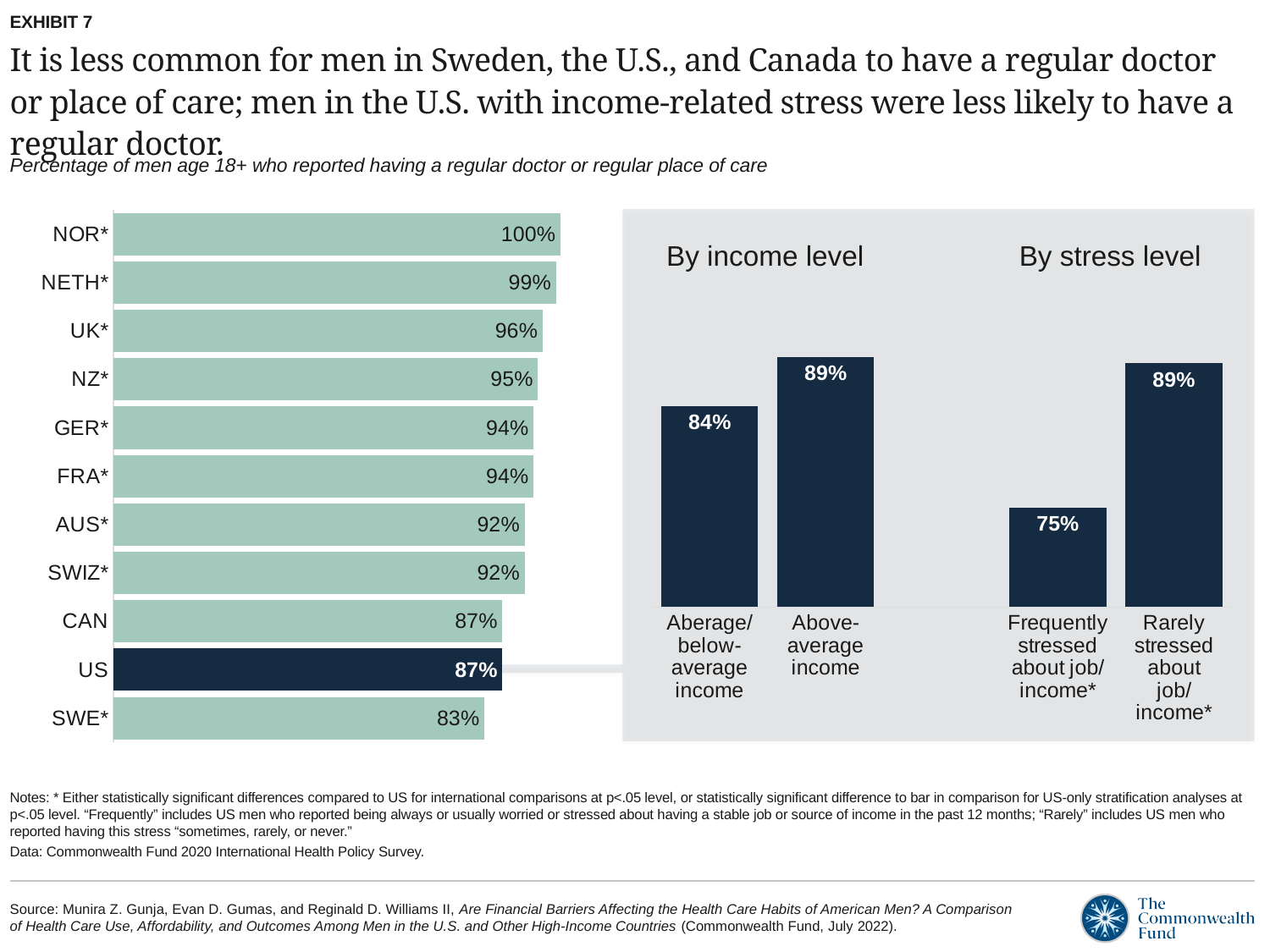
How many countries are shown in the left-hand country bar chart? 11 In the left-hand country bar chart, which country has the lowest percentage? SWE* In the left-hand country bar chart, what percentage is shown for NOR*? 100% In the 'By income level' chart, what is the difference between the above-average income bar and the average/below-average income bar? 5 percentage points In the 'By stress level' chart, which group has the larger percentage: frequently stressed or rarely stressed about job/income? Rarely stressed about job/income* In the 'By stress level' chart, what percentage is shown for men frequently stressed about job/income? 75% What type of chart is the left-hand chart showing countries? Bar chart In the left-hand country bar chart, which country has the highest percentage? NOR* In the left-hand country bar chart, what percentage is shown for SWE*? 83% In the left-hand country bar chart, what percentage is shown for the US? 87% In the 'By income level' chart, what percentage is shown for men with above-average income? 89% In the left-hand country bar chart, what is the difference between the percentages for NETH* and CAN? 12 percentage points